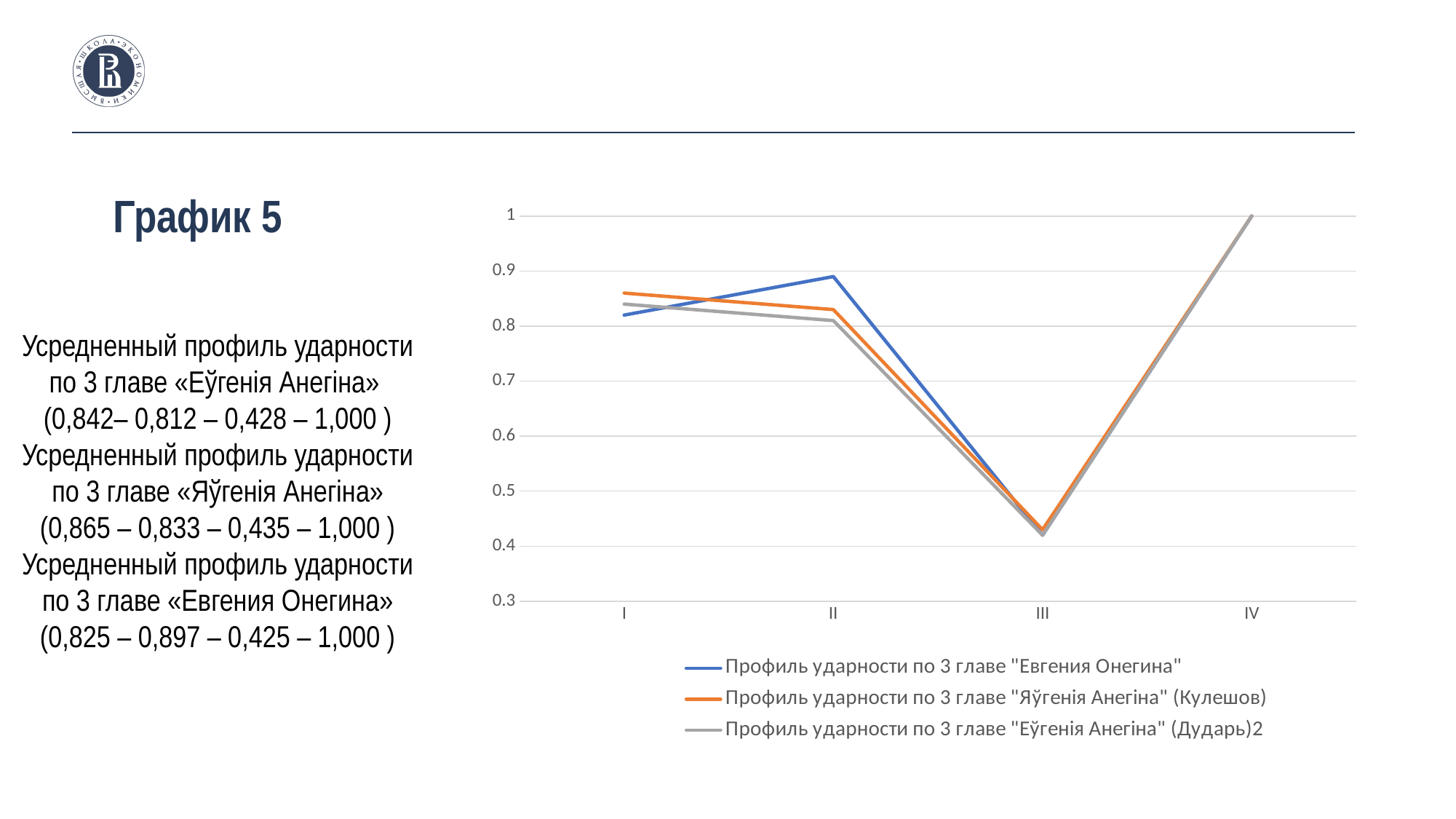
At which x-axis category does the series 'Профиль ударности по 3 главе "Евгения Онегина"' reach its highest value? IV What is the title given to the chart on the slide? График 5 What kind of chart is shown on the slide? line chart At category II, which series has the larger value: 'Профиль ударности по 3 главе "Евгения Онегина"' or 'Профиль ударности по 3 главе "Еўгенія Анегіна" (Дударь)2'? Профиль ударности по 3 главе "Евгения Онегина" What colour is the line for 'Профиль ударности по 3 главе "Евгения Онегина"'? blue How many series does the legend list? 3 At which x-axis category does the series 'Профиль ударности по 3 главе "Яўгенія Анегіна" (Кулешов)' reach its lowest value? III What is the value of the series 'Профиль ударности по 3 главе "Евгения Онегина"' at category IV? 1 Is the value for 'Профиль ударности по 3 главе "Евгения Онегина"' at category II greater or less than 0.8? greater Do the values of all three series rise or fall from category II to category III? fall How many categories are on the x axis of the chart? 4 Is the value for 'Профиль ударности по 3 главе "Яўгенія Анегіна" (Кулешов)' at category III greater or less than 0.5? less